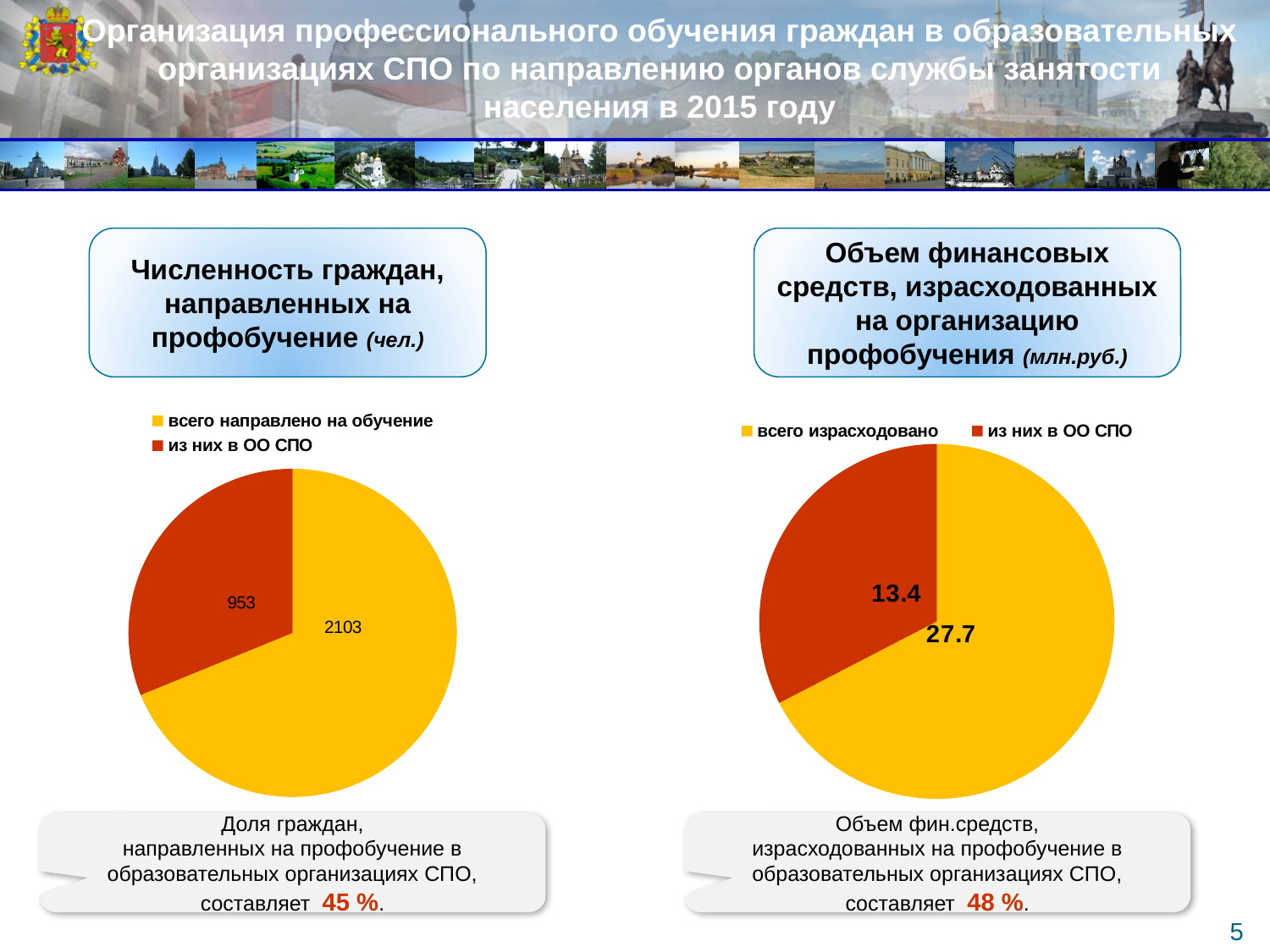
On the right pie chart, which is larger: "всего израсходовано" or "из них в ОО СПО"? всего израсходовано On the right pie chart, which slice is the smallest? из них в ОО СПО On the left pie chart, what colour is the slice for "из них в ОО СПО"? red On the right pie chart, what is the difference between the values 27.7 and 13.4? 14.3 On the left pie chart, what is the difference between the values 2103 and 953? 1150 On the left pie chart, what is the value for "всего направлено на обучение"? 2103 On the right pie chart, what is the value for "из них в ОО СПО"? 13.4 How many entries does the legend of the right pie chart list? 2 On the right pie chart, what is the value for "всего израсходовано"? 27.7 On the left pie chart, what is the value for "из них в ОО СПО"? 953 What type of chart is shown on the left side of the slide? pie chart On the left pie chart, which slice is the largest? всего направлено на обучение